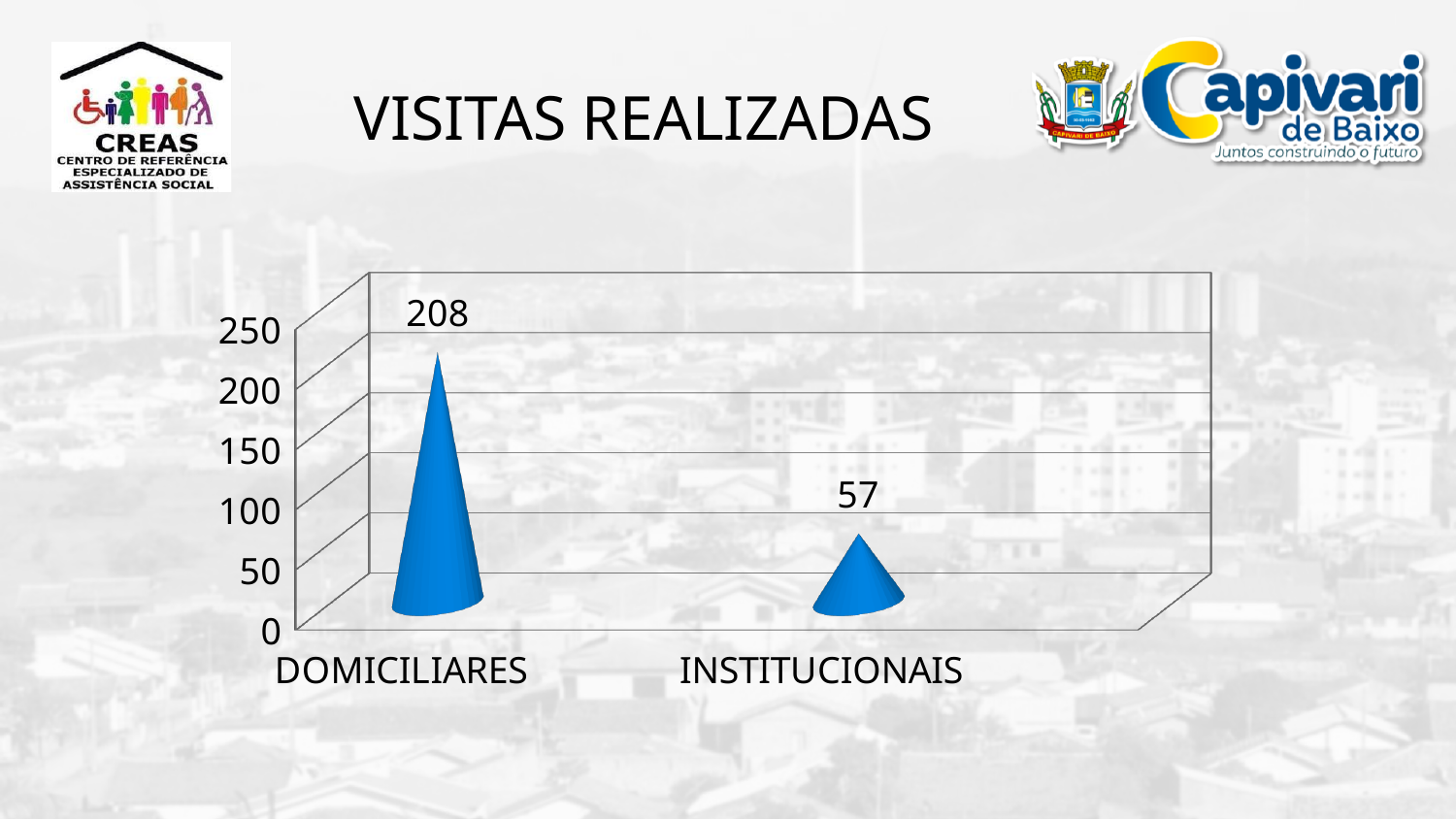
What is the value for INSTITUCIONAIS? 57 What is the difference between the values for DOMICILIARES and INSTITUCIONAIS? 151 Which category has the highest value? DOMICILIARES Which category has the lowest value? INSTITUCIONAIS Is the value for INSTITUCIONAIS greater or less than 100? less Is the value for DOMICILIARES greater or less than 200? greater What is the title of the slide? VISITAS REALIZADAS What is the highest value shown on the vertical axis? 250 What kind of chart is shown on the slide? bar chart How many categories are shown on the chart? 2 What is the value for DOMICILIARES? 208 Which is larger, the value for DOMICILIARES or the value for INSTITUCIONAIS? DOMICILIARES